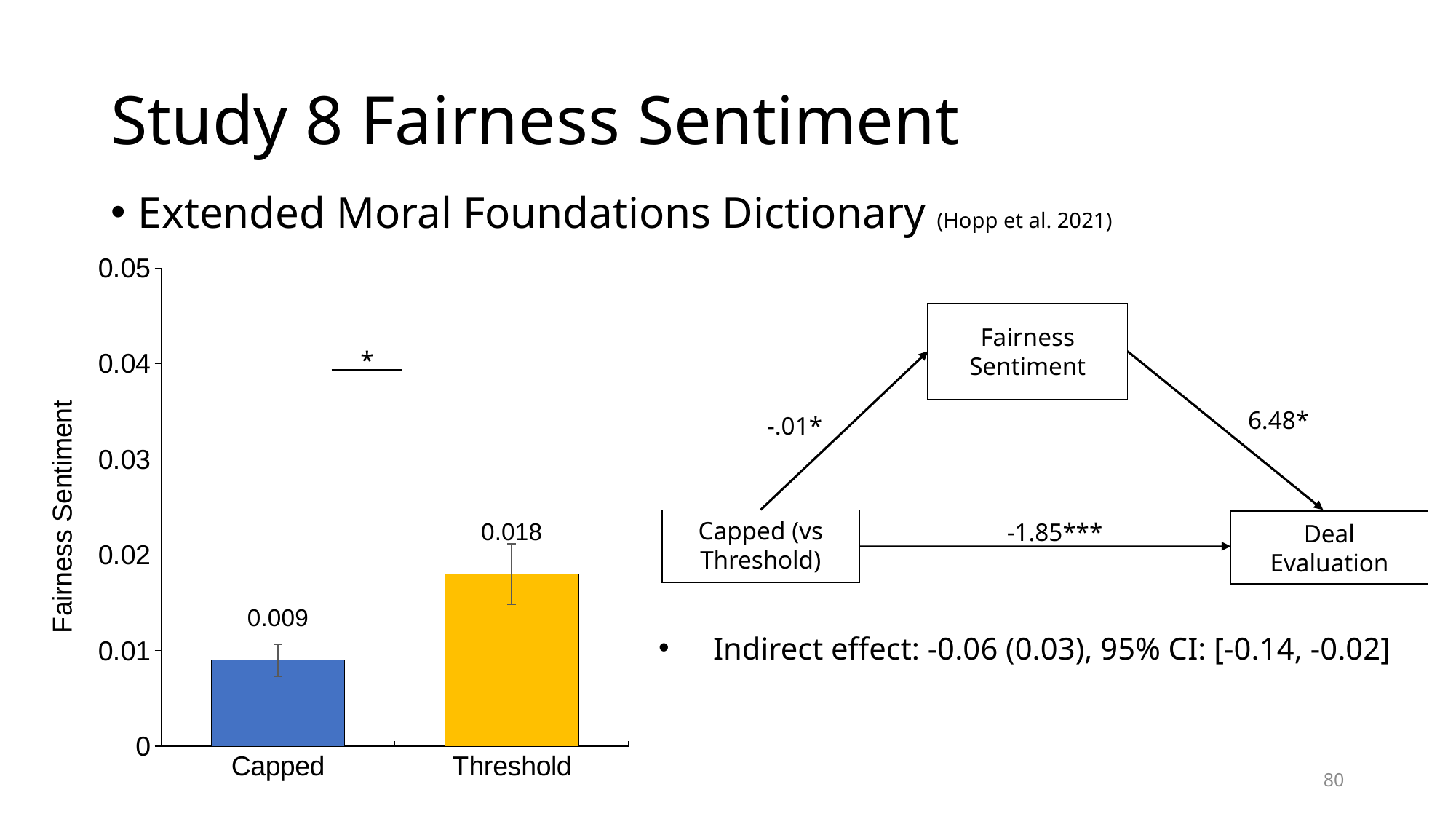
How many conditions are shown on the x axis of the bar chart? 2 Is the Fairness Sentiment value for Threshold greater or less than 0.02? less Is the Fairness Sentiment value for Capped greater or less than 0.01? less What is the maximum value shown on the y axis of the bar chart? 0.05 What is the label of the y axis of the bar chart? Fairness Sentiment What is the Fairness Sentiment value for the Threshold condition? 0.018 What is the Fairness Sentiment value for the Capped condition? 0.009 What colour is the bar for the Threshold condition? yellow What type of chart is used to show Fairness Sentiment by condition? bar chart What is the difference in Fairness Sentiment between the Threshold and Capped conditions? 0.009 Which condition has the lower Fairness Sentiment? Capped Which condition has the higher Fairness Sentiment? Threshold